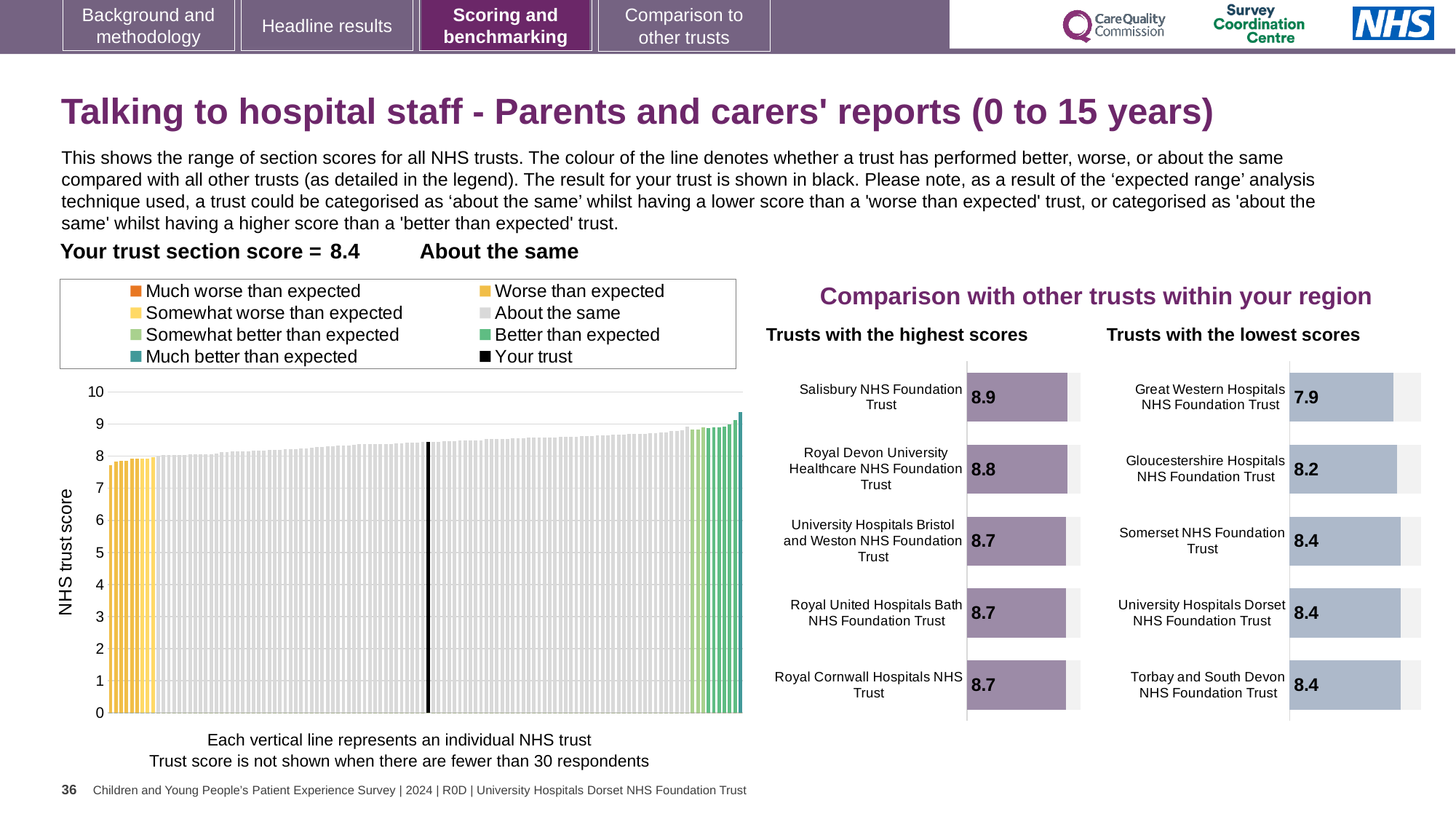
In the 'Trusts with the lowest scores' chart, what is the difference between the scores of Gloucestershire Hospitals NHS Foundation Trust and Great Western Hospitals NHS Foundation Trust? 0.3 In the 'Trusts with the highest scores' chart, which trust has the highest score? Salisbury NHS Foundation Trust In the 'Trusts with the lowest scores' chart, which trust has the lowest score? Great Western Hospitals NHS Foundation Trust In the 'Trusts with the lowest scores' chart, what is the score for Great Western Hospitals NHS Foundation Trust? 7.9 In the 'Trusts with the lowest scores' chart, what is the score for Gloucestershire Hospitals NHS Foundation Trust? 8.2 In the 'Trusts with the highest scores' chart, what is the score for Salisbury NHS Foundation Trust? 8.9 In the 'Trusts with the highest scores' chart, what is the score for Royal Devon University Healthcare NHS Foundation Trust? 8.8 In the 'Trusts with the lowest scores' chart, which has the larger score: Gloucestershire Hospitals NHS Foundation Trust or Great Western Hospitals NHS Foundation Trust? Gloucestershire Hospitals NHS Foundation Trust In the large chart on the left, is the value for the black 'Your trust' bar greater or less than 8? greater How many trusts are listed in the 'Trusts with the highest scores' chart? 5 In the 'Trusts with the highest scores' chart, what is the difference between the scores of Salisbury NHS Foundation Trust and Royal Cornwall Hospitals NHS Trust? 0.2 What kind of chart is the large chart on the left showing NHS trust scores? Bar chart